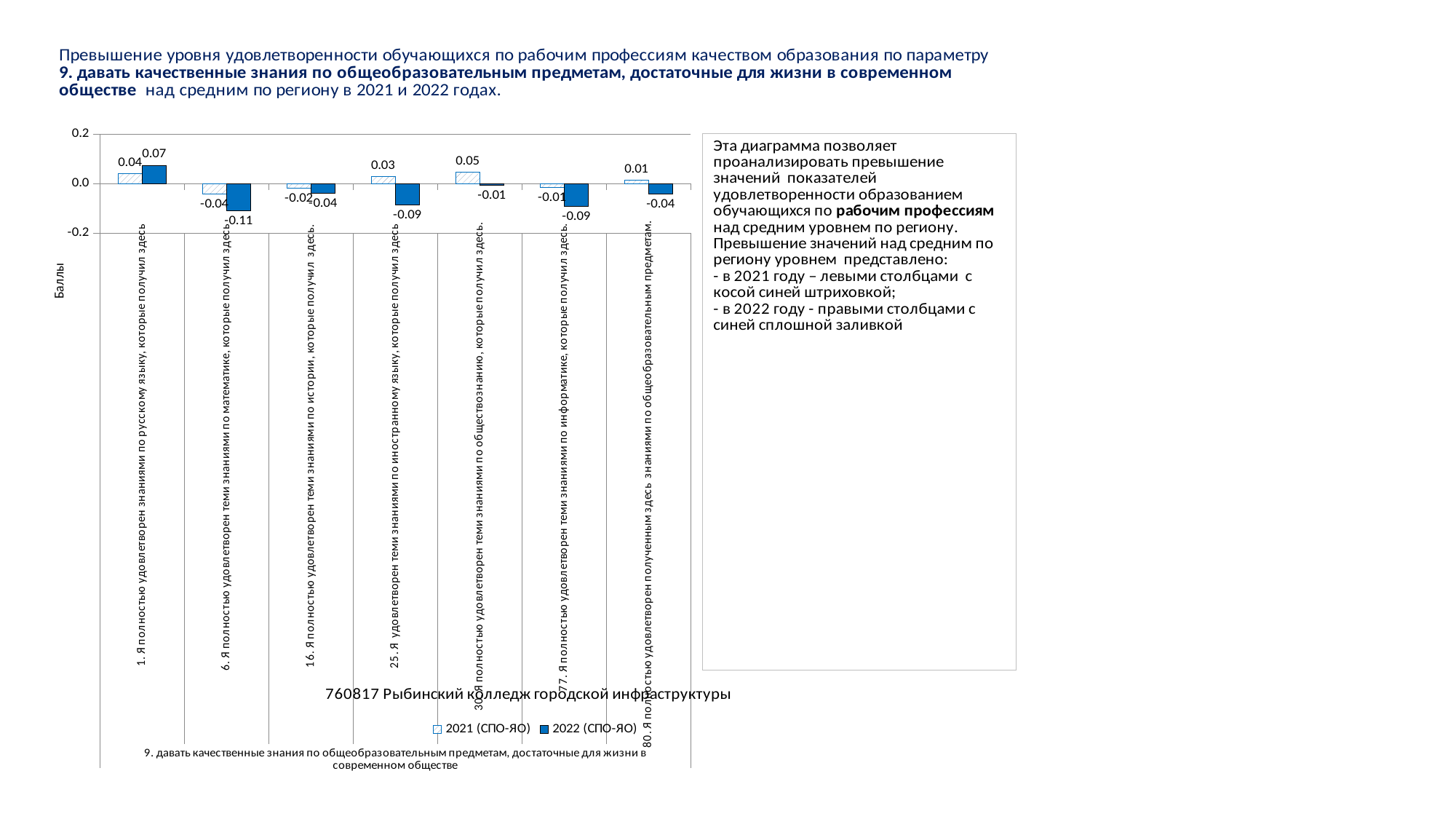
How many categories are shown on the x axis? 7 What is the 2021 (СПО-ЯО) value for category 6 (математике)? -0.04 What is the 2022 (СПО-ЯО) value for category 25 (иностранному языку)? -0.09 What is the 2021 (СПО-ЯО) value for category 30 (обществознанию)? 0.05 What kind of chart is shown on the slide? Bar chart How many series does the legend list? 2 Which category has the lowest 2022 (СПО-ЯО) value? 6. Я полностью удовлетворен теми знаниями по математике What is the label of the vertical axis? Баллы Which category has the highest 2021 (СПО-ЯО) value? 30. Я полностью удовлетворен теми знаниями по обществознанию What is the difference between the 2021 and 2022 values for category 25 (иностранному языку)? 0.12 What is the 2022 (СПО-ЯО) value for category 1 (русскому языку)? 0.07 For category 1 (русскому языку), which is larger: the 2021 value or the 2022 value? 2022